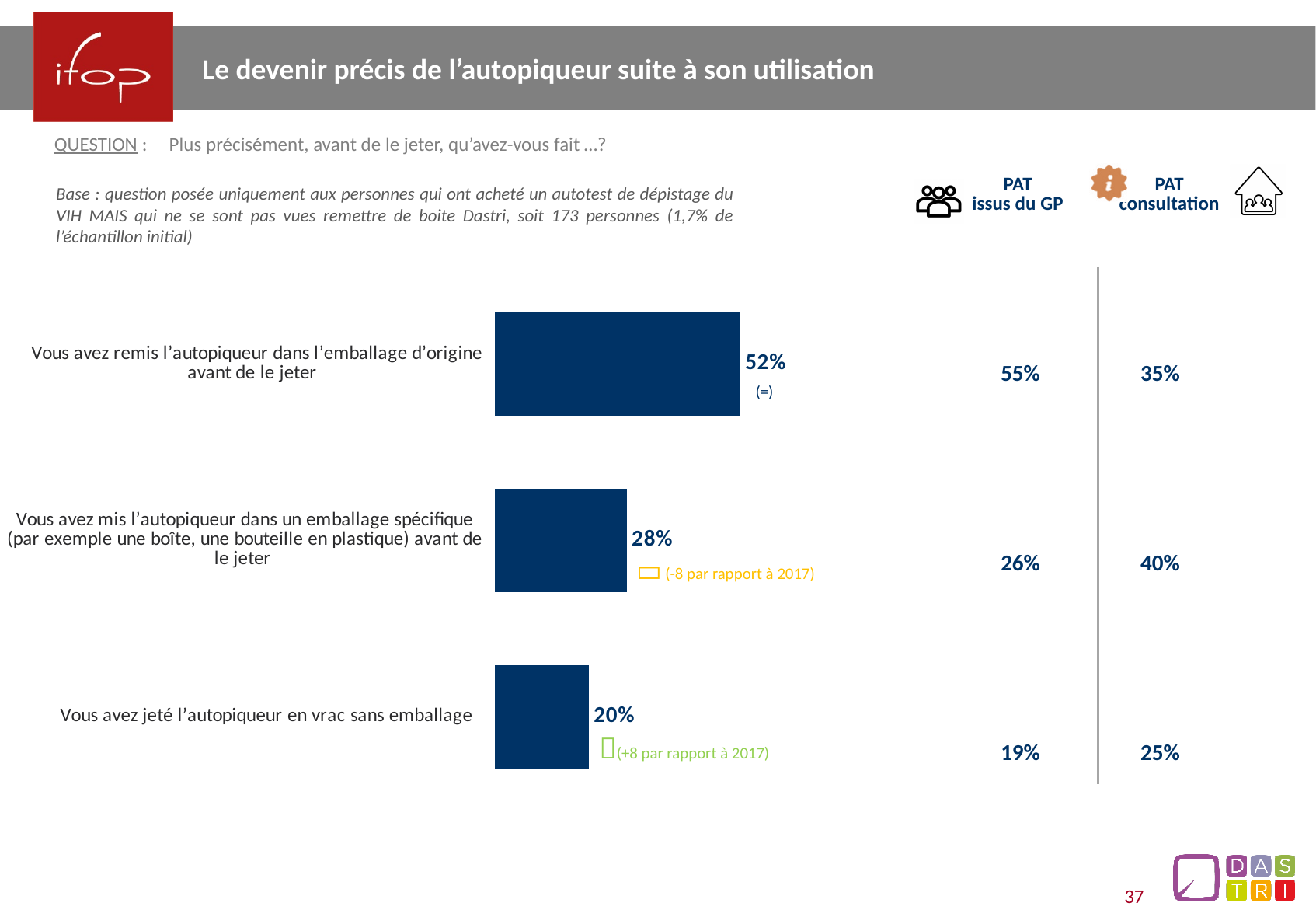
Which is larger: the share who used a specific packaging or the share who threw the device away loose? Vous avez mis l'autopiqueur dans un emballage spécifique (28%) What percentage of respondents put the lancing device back in its original packaging before throwing it away? 52% What is the change compared to 2017 for putting the device in a specific packaging? -8 What percentage of respondents put the lancing device in a specific packaging (e.g. a box or plastic bottle) before throwing it away? 28% Which response category has the lowest percentage in the bar chart? Vous avez jeté l'autopiqueur en vrac sans emballage What is the change compared to 2017 for throwing the device away loose without packaging? +8 In the 'PAT consultation' column, what percentage put the device in a specific packaging before throwing it away? 40% Which response category has the highest percentage in the bar chart? Vous avez remis l'autopiqueur dans l'emballage d'origine avant de le jeter What type of chart is used on this slide? Bar chart What is the difference in percentage points between putting the device back in its original packaging (52%) and throwing it away loose (20%)? 32 How many response categories are shown in the bar chart? 3 What percentage of respondents threw the lancing device away loose without packaging? 20%